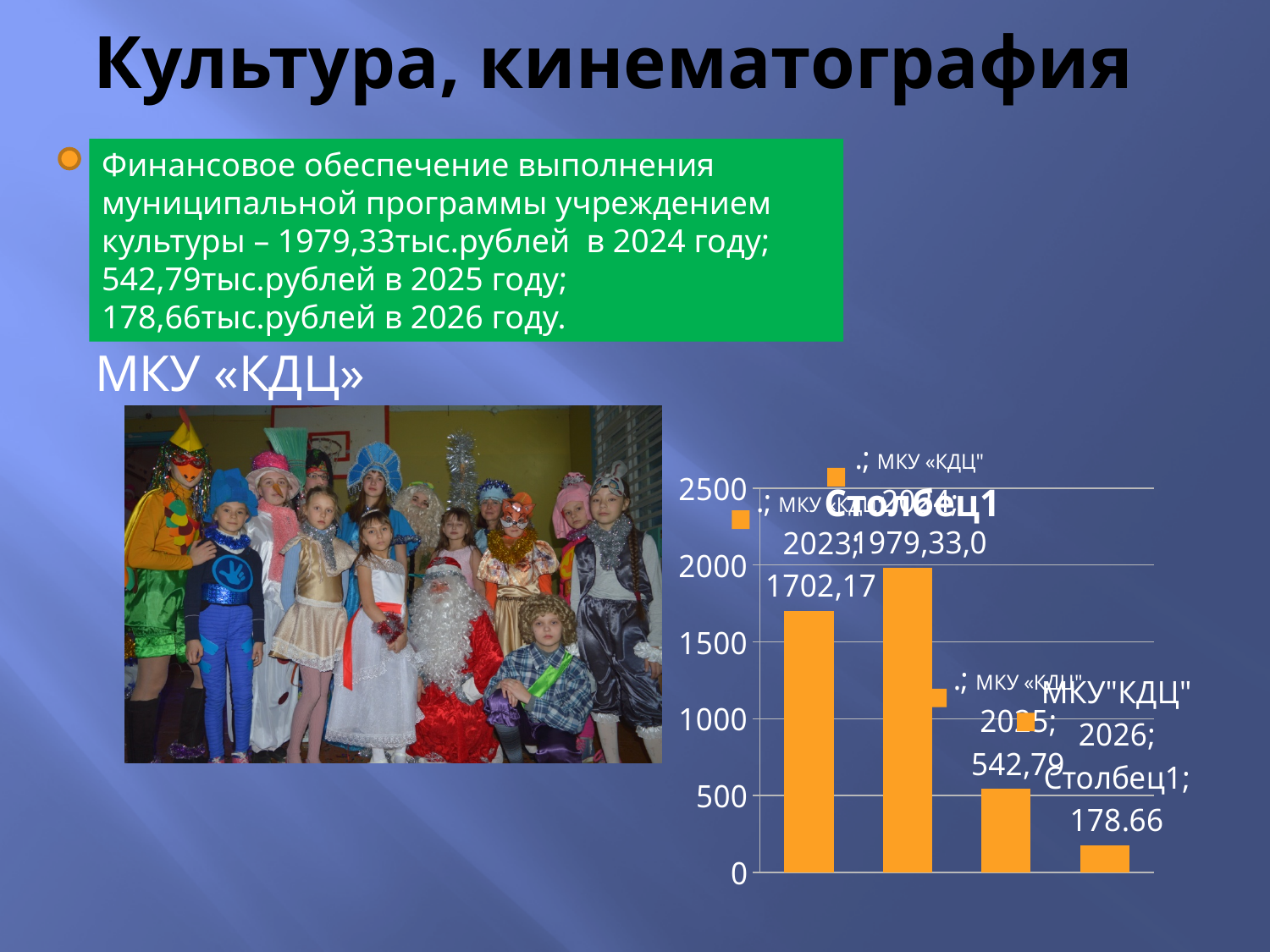
Is the value for 2024 greater or less than 1500? greater What value is labelled on the bar for 2025? 542,79 What colour are the bars in the chart? orange Do the bar values rise or fall from 2024 to 2026? fall Which bar is taller, 2023 or 2025? 2023 What kind of chart is shown on the slide? bar chart How many bars are plotted in the chart? 4 Which year has the highest bar in the chart? 2024 Is the value for 2026 greater or less than 500? less What value is labelled on the bar for 2026? 178.66 What value is labelled on the bar for 2023? 1702,17 Which year has the lowest bar in the chart? 2026